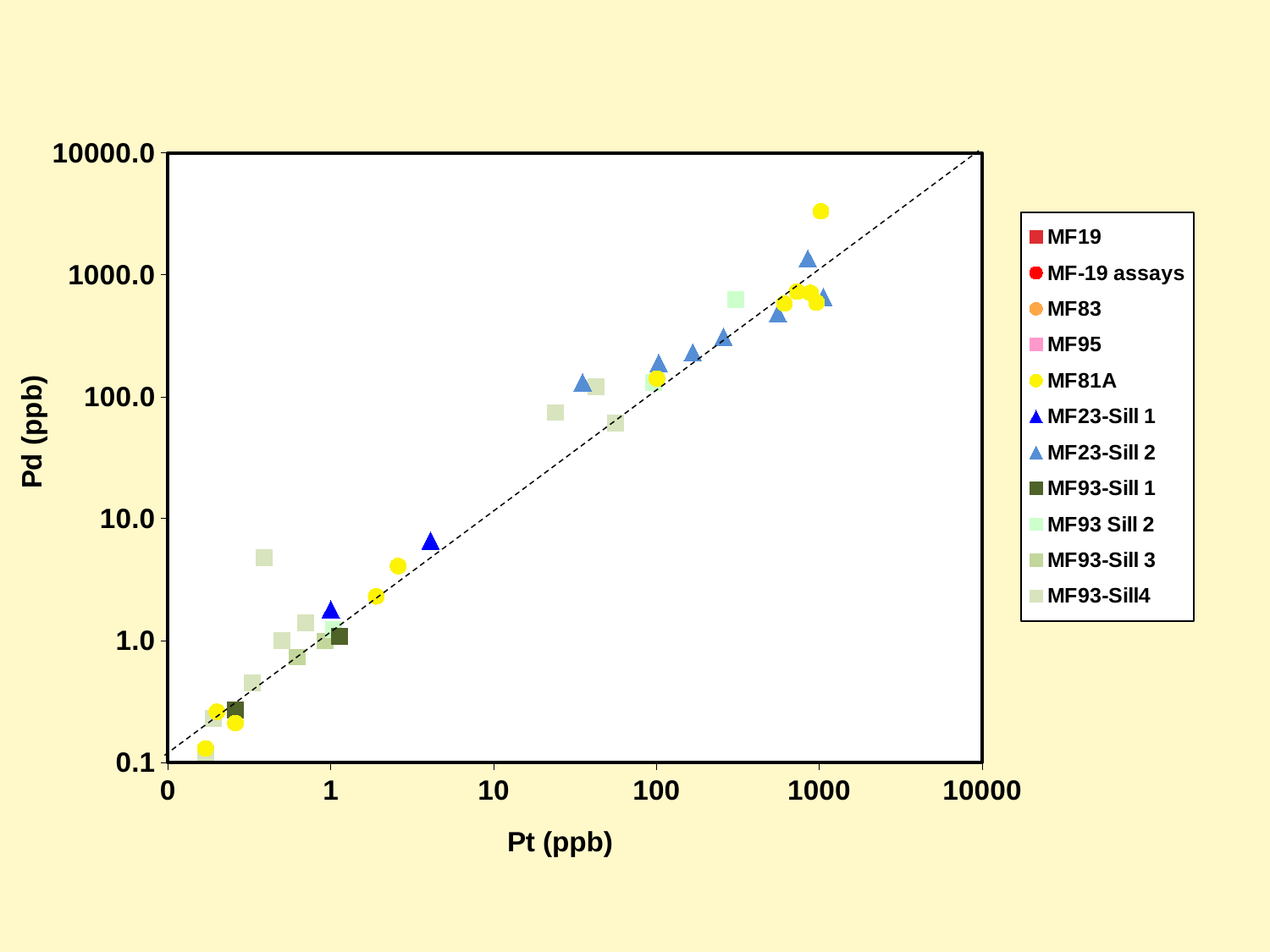
Is the Pd value of the highest MF23-Sill 2 point greater or less than 1000? greater What is the label of the x axis? Pt (ppb) Is the Pd value of the MF93-Sill4 point at Pt of about 0.4 greater or less than 1.0? greater Is the highest Pd value plotted for MF81A greater or less than 1000? greater Do the Pd values generally rise or fall as Pt increases along the x axis? Rise How many series does the legend list? 11 Which series has the point with the highest Pd value on the chart? MF81A How many MF23-Sill 1 points are plotted on the chart? 2 What is the label of the y axis? Pd (ppb) How many MF93-Sill 1 points are plotted on the chart? 2 What kind of chart is shown on the slide? Scatter chart